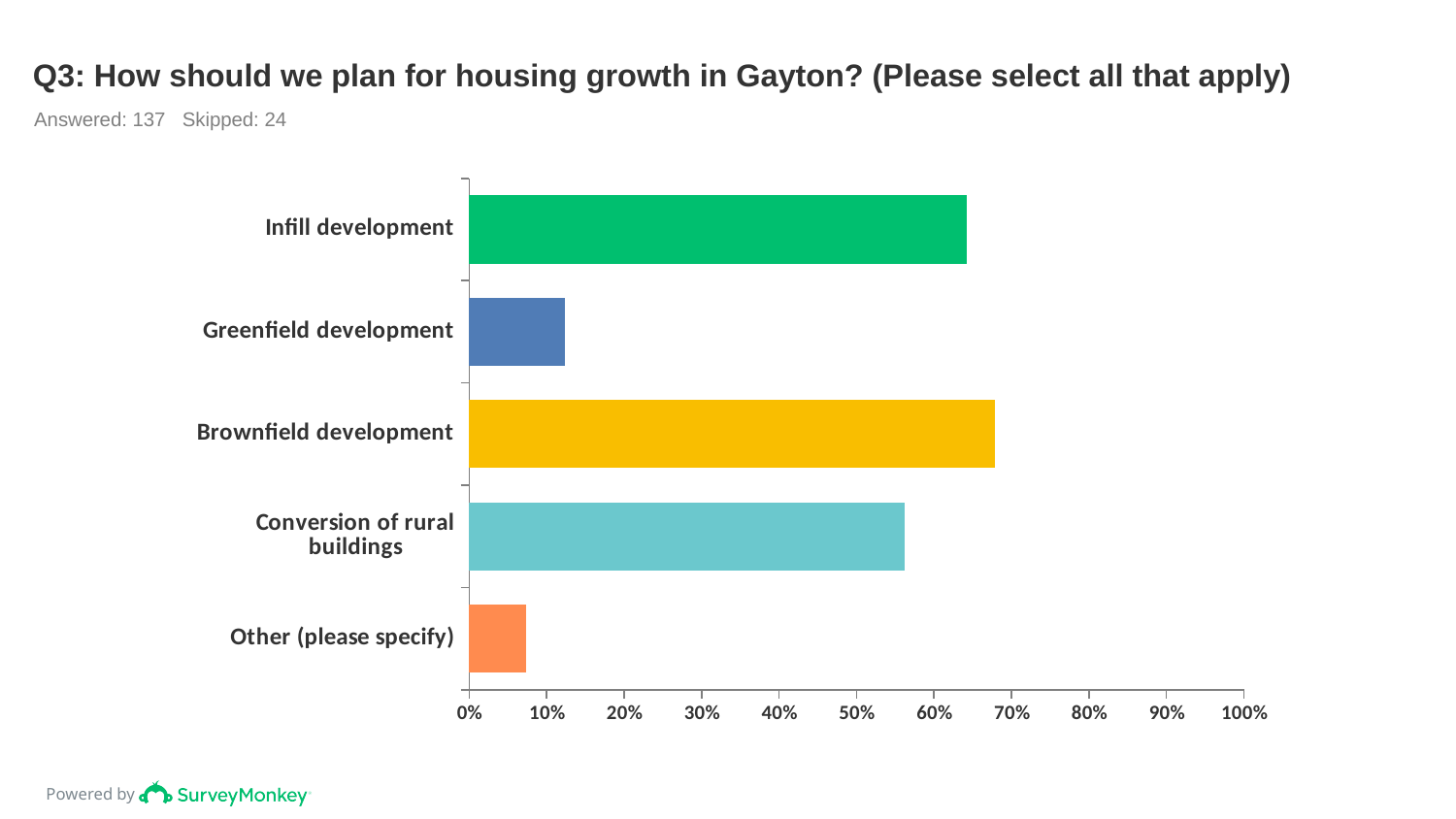
Which is larger, the value for Conversion of rural buildings or the value for Brownfield development? Brownfield development Which category has the highest value? Brownfield development Is the value for Infill development greater or less than 60%? greater How many categories (answer options) are plotted in the chart? 5 Which is larger, the value for Infill development or the value for Greenfield development? Infill development Which category has the lowest value? Other (please specify) How many respondents answered this question according to the slide? 137 Is the value for Conversion of rural buildings greater or less than 50%? greater Is the value for Other (please specify) greater or less than 10%? less What kind of chart is shown on the slide? bar chart